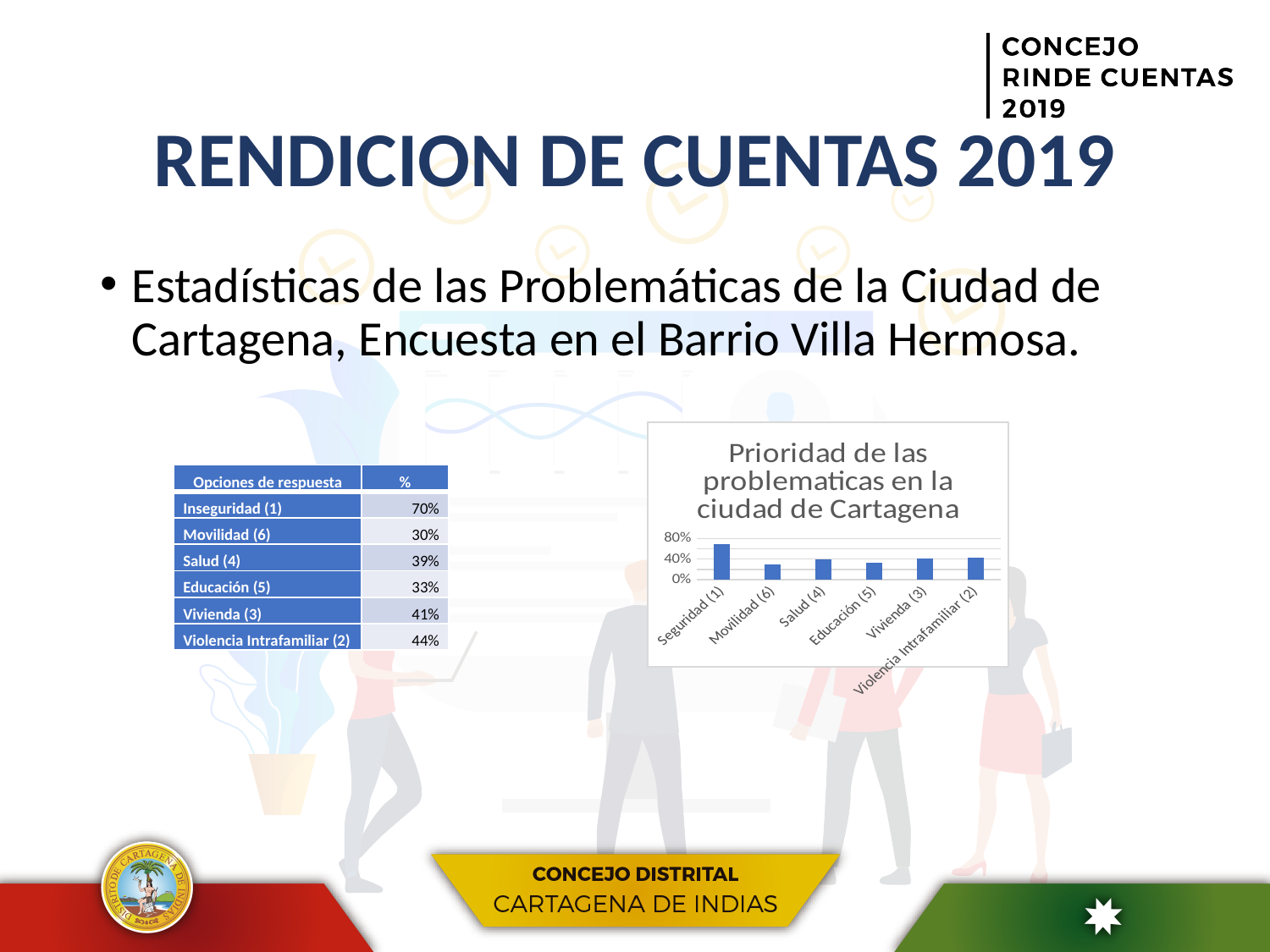
What is the title of the chart? Prioridad de las problematicas en la ciudad de Cartagena Which is larger, the value for Seguridad (1) or the value for Movilidad (6)? Seguridad (1) According to the table on the slide, what percentage corresponds to Violencia Intrafamiliar (2)? 44% Is the value for Educación (5) greater or less than 40%? less Which category has the lowest value in the chart? Movilidad (6) According to the table on the slide, what percentage corresponds to Vivienda (3)? 41% Using the percentages in the table, what is the difference between Inseguridad (1) and Movilidad (6)? 40% Is the value for Seguridad (1) greater or less than 40%? greater How many categories are plotted in the chart? 6 Is the value for Movilidad (6) greater or less than 40%? less What kind of chart is shown on the slide? bar chart Which category has the highest value in the chart? Seguridad (1)